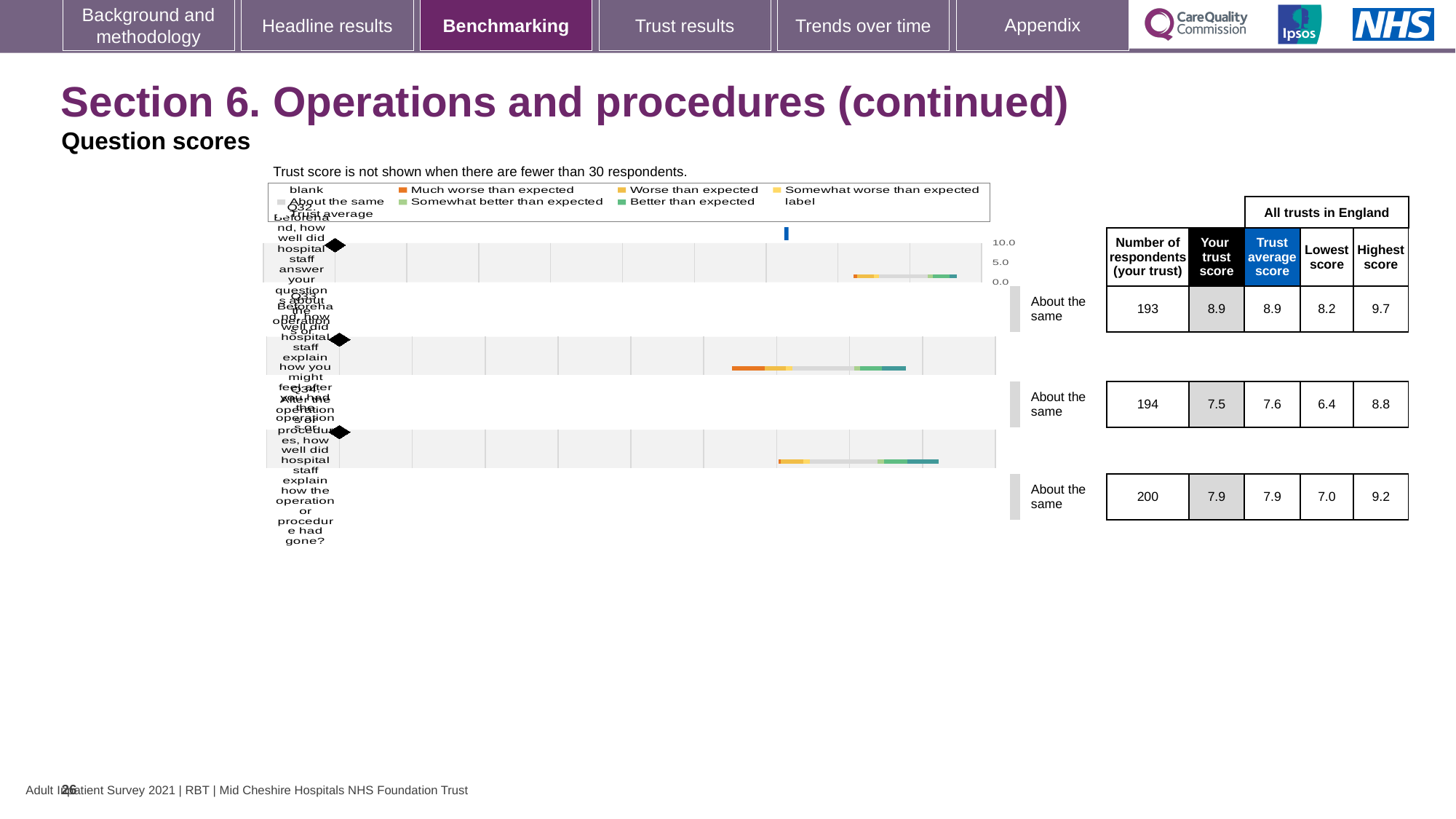
What is the difference between the 'Highest score' and 'Lowest score' for the first row (193 respondents)? 1.5 What kind of chart is used to show the benchmarking results on this slide? bar chart What is the 'Lowest score' for the second row (194 respondents)? 6.4 Is the 'Your trust score' for the third row (200 respondents) larger or smaller than its 'Trust average score'? the same (7.9) Which row has the highest 'Your trust score'? the first row (193 respondents) How many question rows are shown in the benchmarking chart? 3 What benchmark category is shown for all three rows? About the same What is the highest value shown on the chart's score axis? 10.0 Which row has the lowest 'Your trust score'? the second row (194 respondents) What is the 'Trust average score' for the second row (194 respondents)? 7.6 What is the 'Your trust score' for the first row (193 respondents)? 8.9 What is the 'Highest score' for the third row (200 respondents)? 9.2